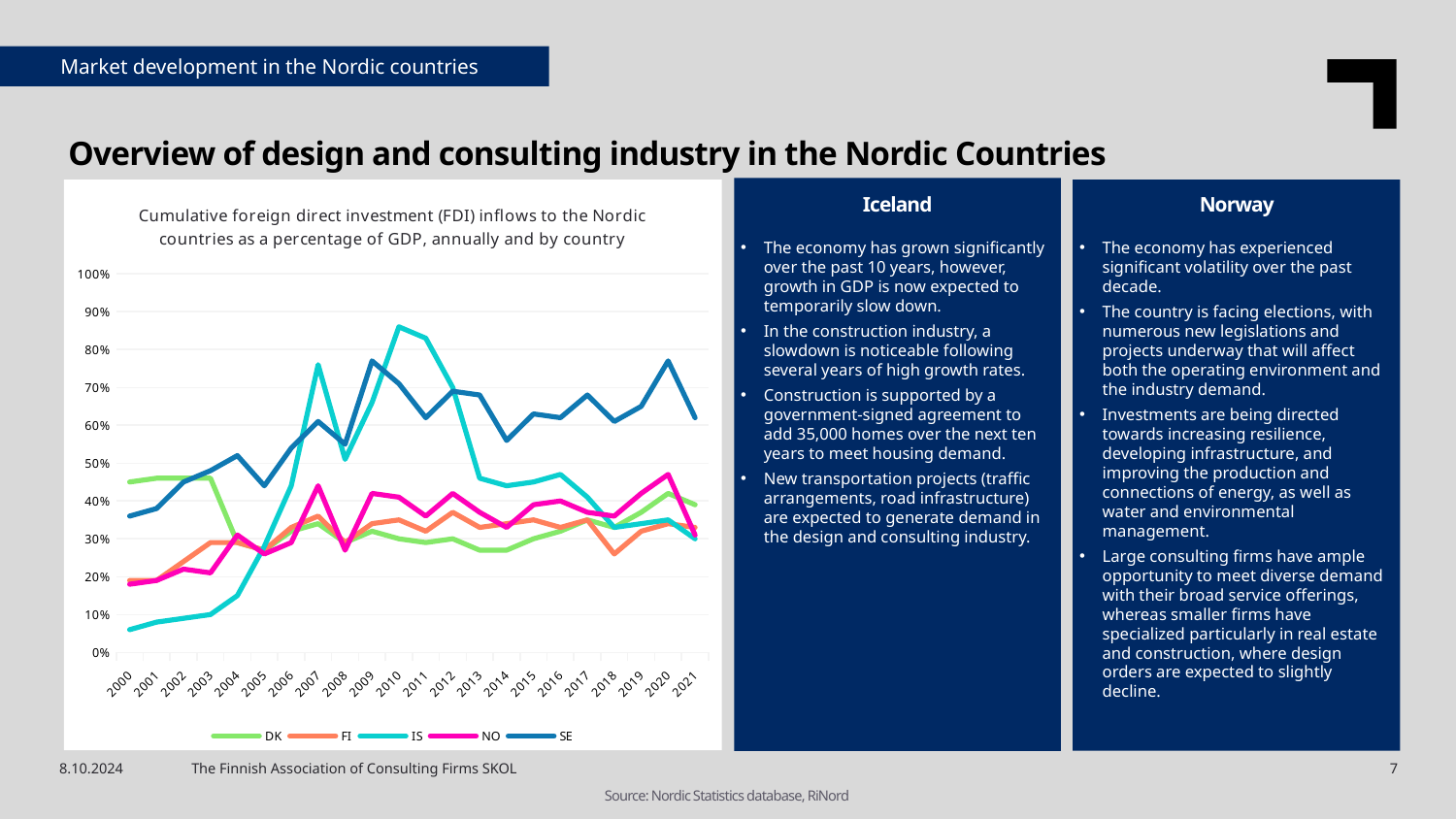
How many years are shown along the x axis of the chart? 22 What kind of chart is shown on the slide? Line chart Which series is shown in the legend between FI and NO? IS Which is larger in 2021, the value for SE or the value for FI? SE Is the value for IS in 2010 greater or less than 80%? greater Which series has the highest value in 2010? IS Is the value for IS in 2000 greater or less than 10%? less Is the value for SE in 2020 greater or less than 70%? greater Which series has the lowest value in 2000? IS How many series does the chart's legend list? 5 Does the IS series rise or fall between 2000 and 2010? Rise